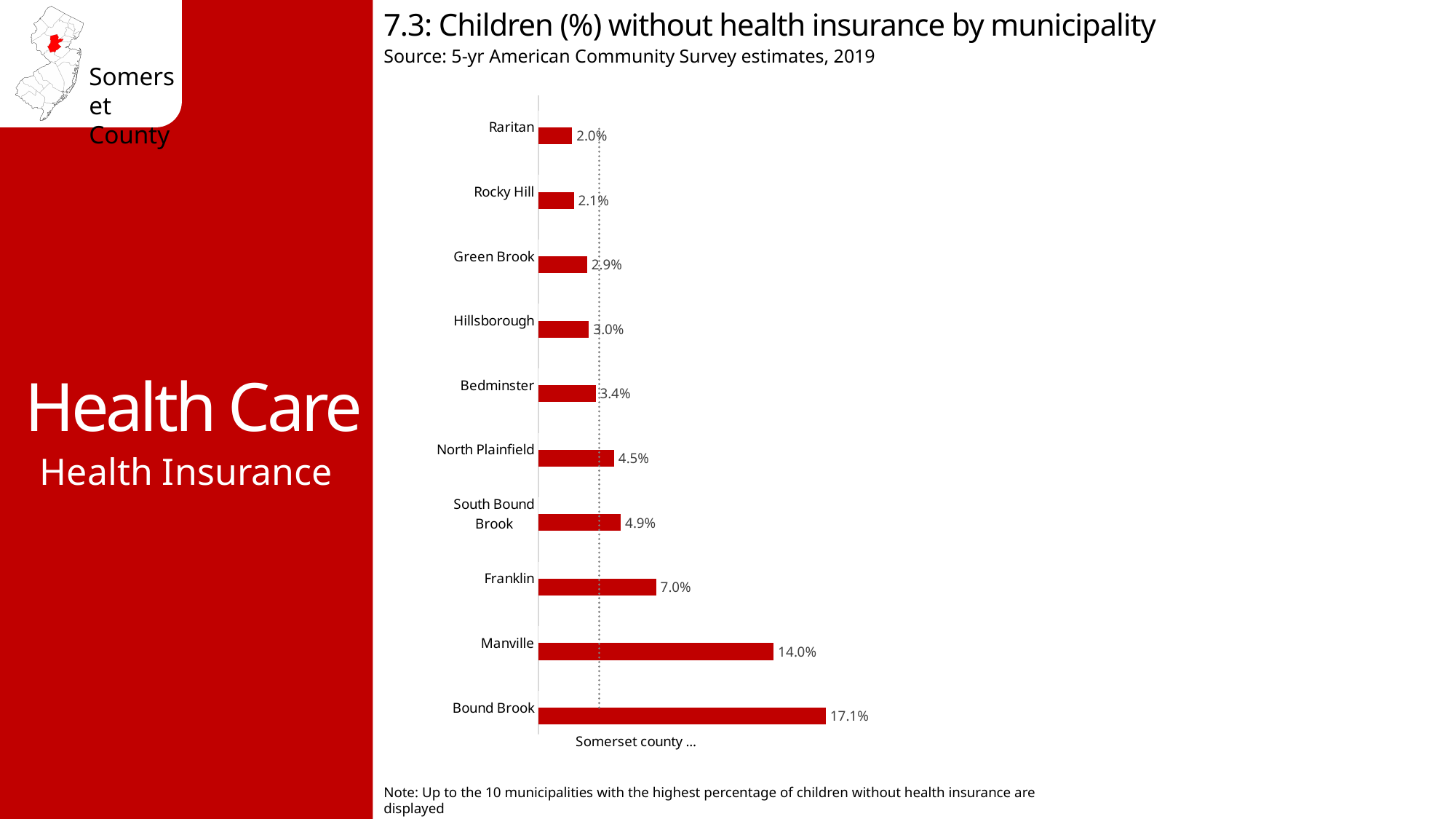
How many municipalities are shown in the chart? 10 What is the difference between the values for South Bound Brook and North Plainfield? 0.4% What percentage of children in Bound Brook are without health insurance? 17.1% Which has a higher value, Franklin or Bedminster? Franklin Which municipality has the lowest percentage of children without health insurance? Raritan Which municipality has the highest percentage of children without health insurance? Bound Brook What percentage is shown for Franklin? 7.0% What is the value shown for Manville? 14.0% What type of chart is used on this slide? Bar chart What is the title of the chart? 7.3: Children (%) without health insurance by municipality What is the difference between the values for Bound Brook and Manville? 3.1% What is the value for Hillsborough? 3.0%